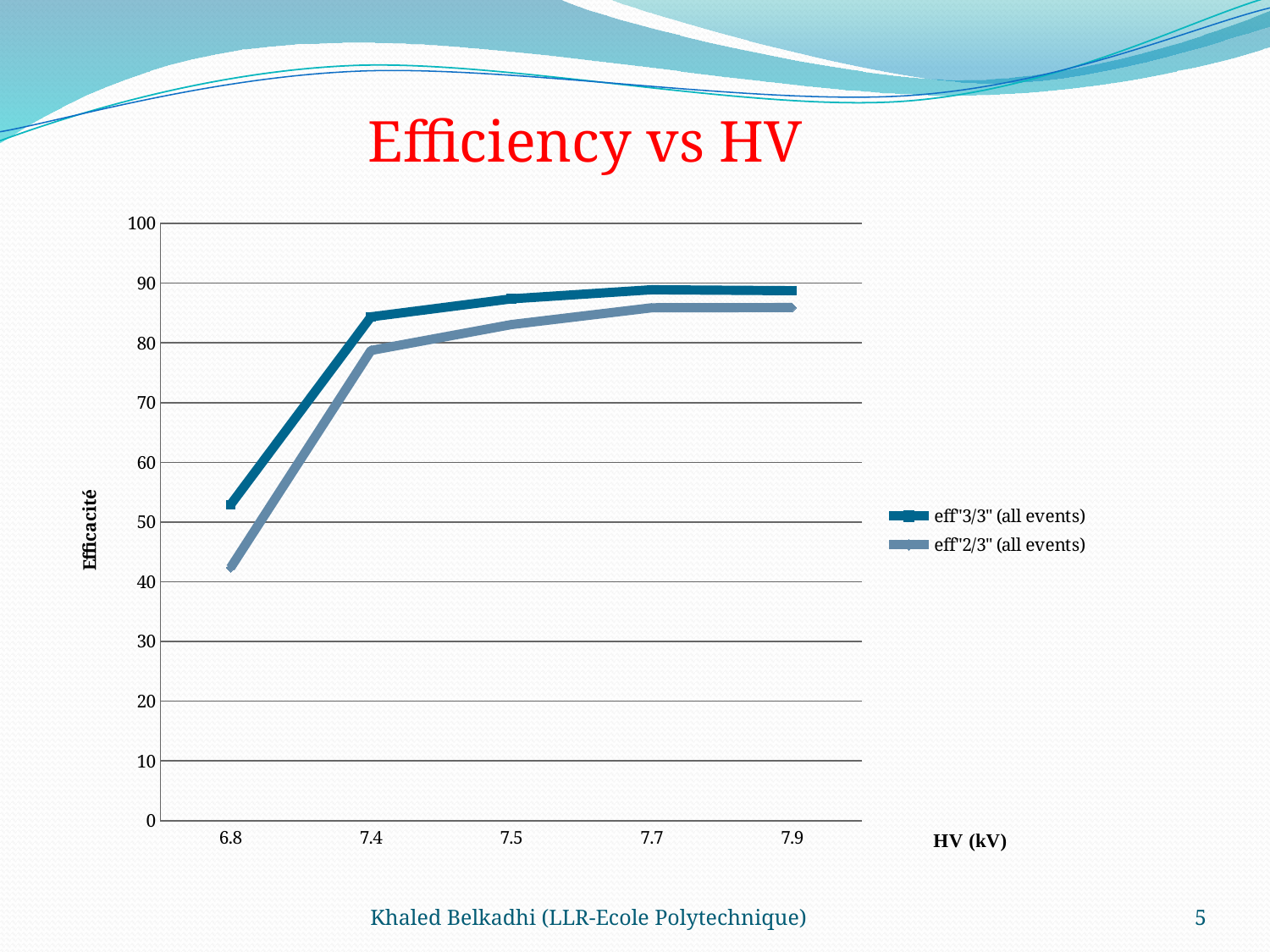
At which HV value is eff"3/3" (all events) lowest? 6.8 How many series does the legend list? 2 Is the value for eff"3/3" (all events) at HV 7.9 greater or less than 90? less What kind of chart is shown on the slide? line chart At which HV value is eff"2/3" (all events) lowest? 6.8 How many HV values are plotted along the x axis? 5 What is the label of the x axis? HV (kV) Is the value for eff"2/3" (all events) at HV 6.8 greater or less than 50? less What is the title of the chart? Efficiency vs HV Is the value for eff"3/3" (all events) at HV 7.4 greater or less than 80? greater At HV 6.8, which series has the larger value, eff"3/3" (all events) or eff"2/3" (all events)? eff"3/3" (all events) Do the values of eff"3/3" (all events) rise or fall as HV increases from 6.8 to 7.9? rise